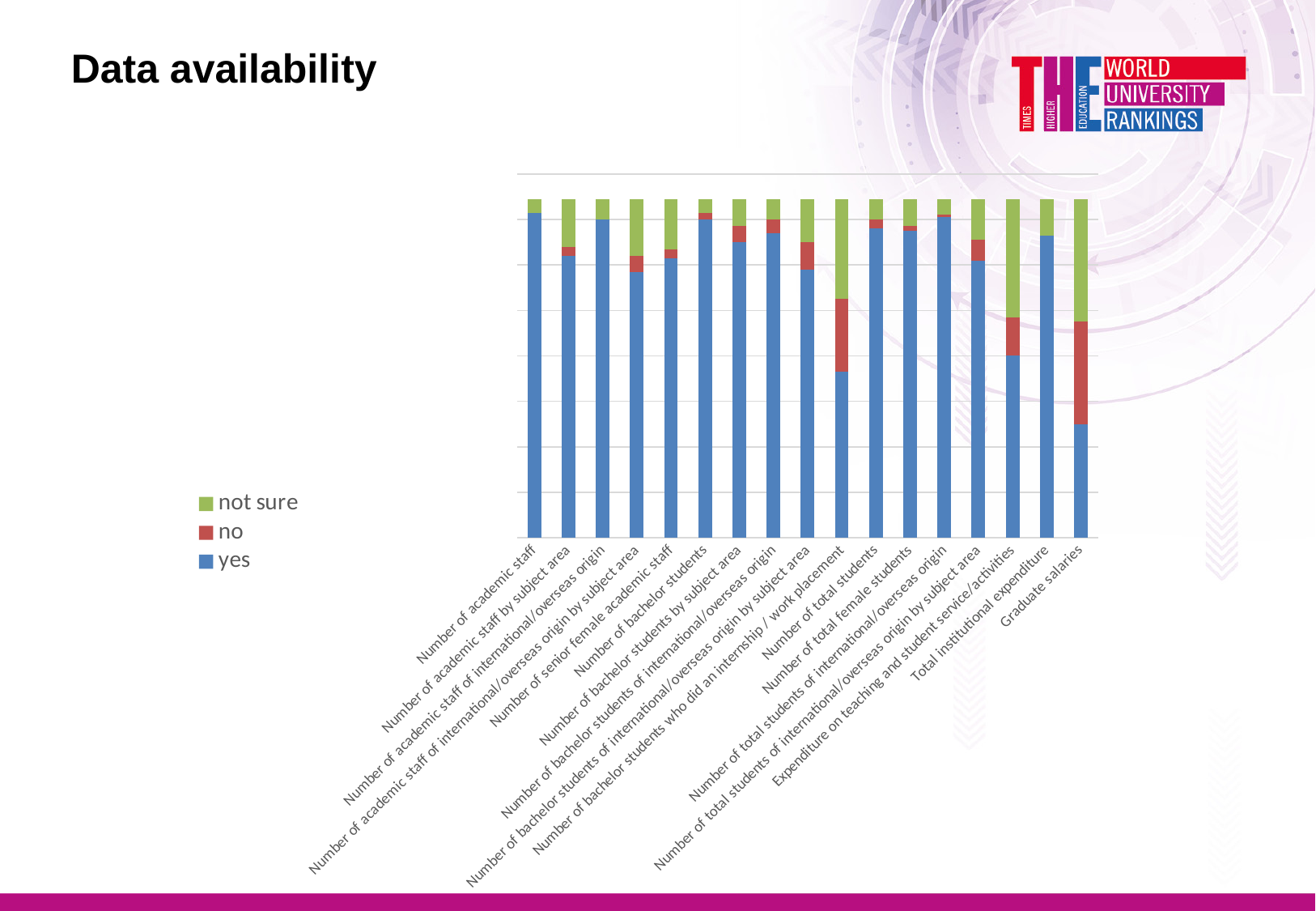
Is the 'yes' segment larger for 'Number of academic staff' or for 'Graduate salaries'? Number of academic staff What kind of chart is shown on the slide? Stacked bar chart What are the three entries listed in the chart's legend? not sure, no, yes Is the 'not sure' segment larger for 'Number of bachelor students who did an internship / work placement' or for 'Number of bachelor students'? Number of bachelor students who did an internship / work placement How many series does the chart's legend list? 3 Is the 'yes' segment larger for 'Number of total students' or for 'Expenditure on teaching and student service/activities'? Number of total students How many categories are plotted along the x axis of the chart? 17 Which category has the largest 'no' segment? Graduate salaries What colour represents the 'yes' series in the chart? Blue Which category has the smallest 'yes' segment? Graduate salaries